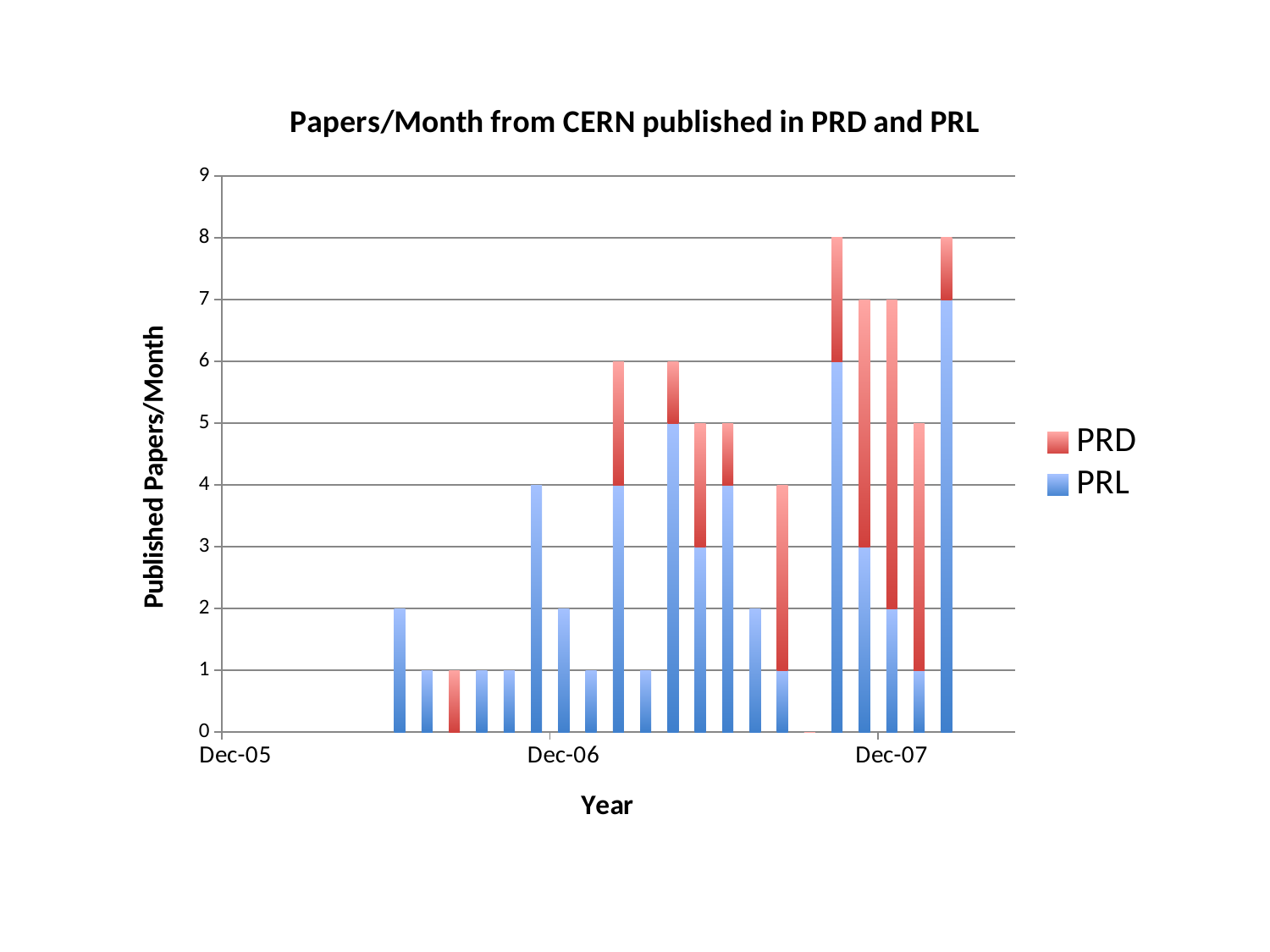
What is the title of the chart? Papers/Month from CERN published in PRD and PRL What kind of chart is shown on the slide? Stacked bar chart What is the highest total papers per month reached by any bar in the chart? 8 Does any bar in the chart exceed 8 papers per month? No What are the two series listed in the legend? PRD and PRL Do the monthly totals generally rise or fall from Dec-05 to Dec-07? Rise How many series does the legend list? 2 Is the tallest bar in the chart greater or less than 7? greater